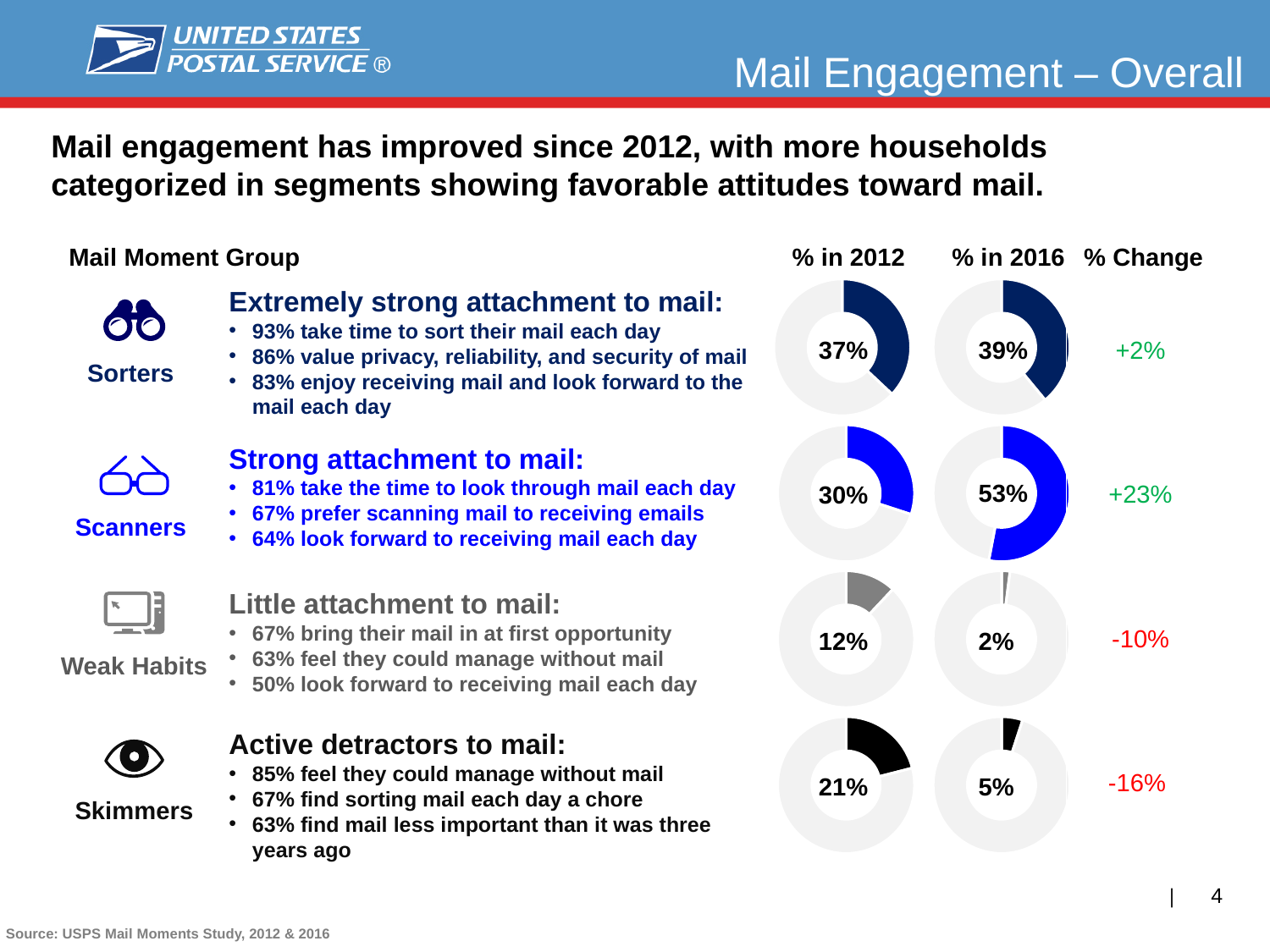
Which Mail Moment Group had the lowest share in 2012? Weak Habits What percentage of households were Sorters in 2012? 37% Which Mail Moment Group had the highest share in 2016? Scanners What percentage of households were Weak Habits in 2016? 2% How many Mail Moment Groups are shown on the slide? 4 What is the difference between the Sorters share in 2016 and the Scanners share in 2016? 14% What is the % Change shown for Skimmers between 2012 and 2016? -16% What is the % Change shown for Scanners between 2012 and 2016? +23% What kind of chart is used to show the percentages for each Mail Moment Group? Donut chart What percentage of households were Skimmers in 2012? 21% What percentage of households were Scanners in 2016? 53% Which was larger in 2012: the share of Sorters or the share of Skimmers? Sorters